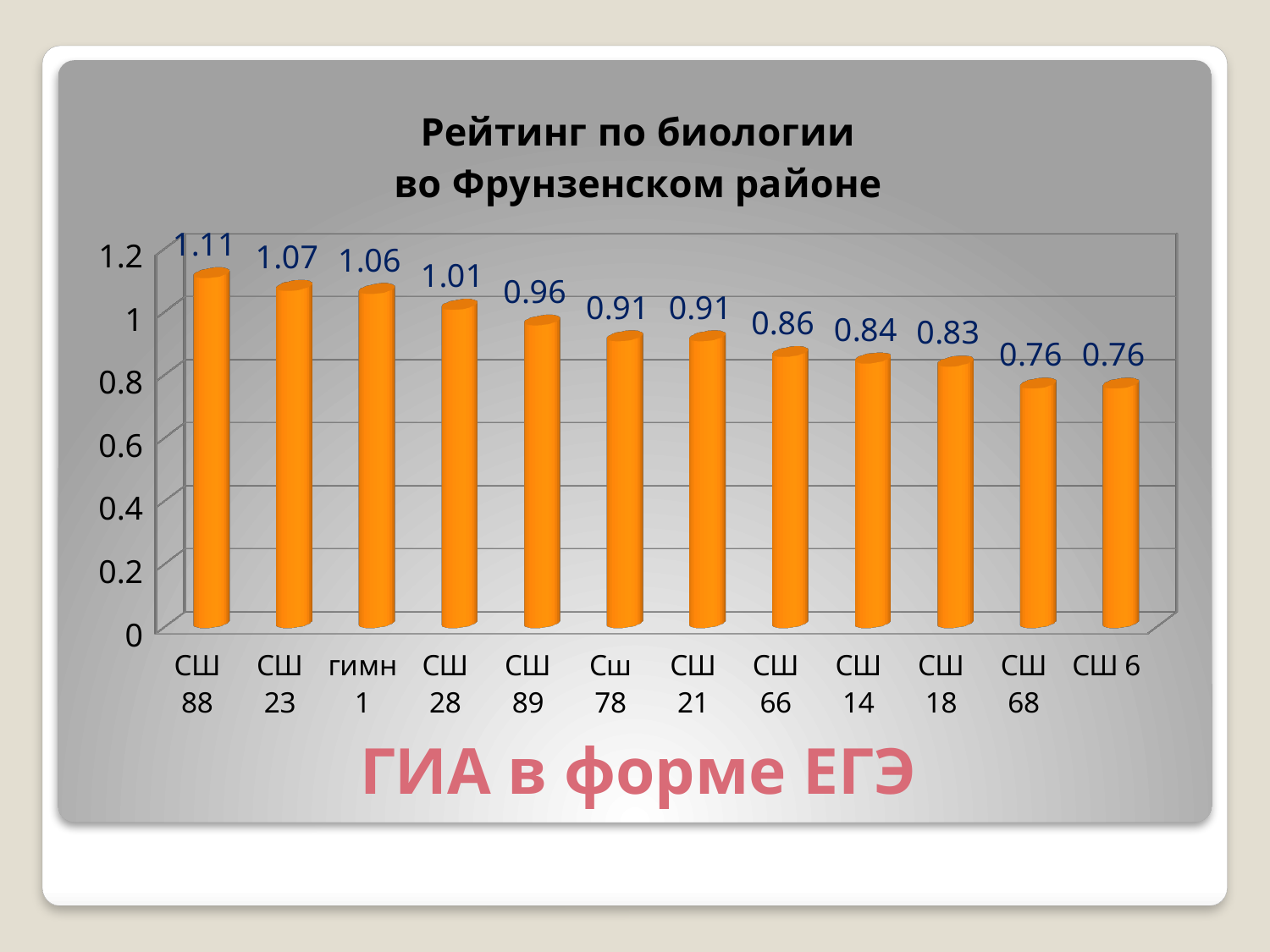
Which category has the highest value? СШ 88 Do the values rise or fall from left to right along the x axis? fall How many categories are shown on the chart? 12 What is the value for СШ 66? 0.86 What is the value for СШ 88? 1.11 What is the difference between the values for СШ 23 and СШ 28? 0.06 What is the difference between the values for СШ 88 and СШ 6? 0.35 What kind of chart is shown on the slide? bar chart What is the value for гимн 1? 1.06 Which is larger, the value for СШ 89 or the value for СШ 14? СШ 89 Is the value for СШ 18 greater or less than 1? less What is the lowest value shown on the chart? 0.76